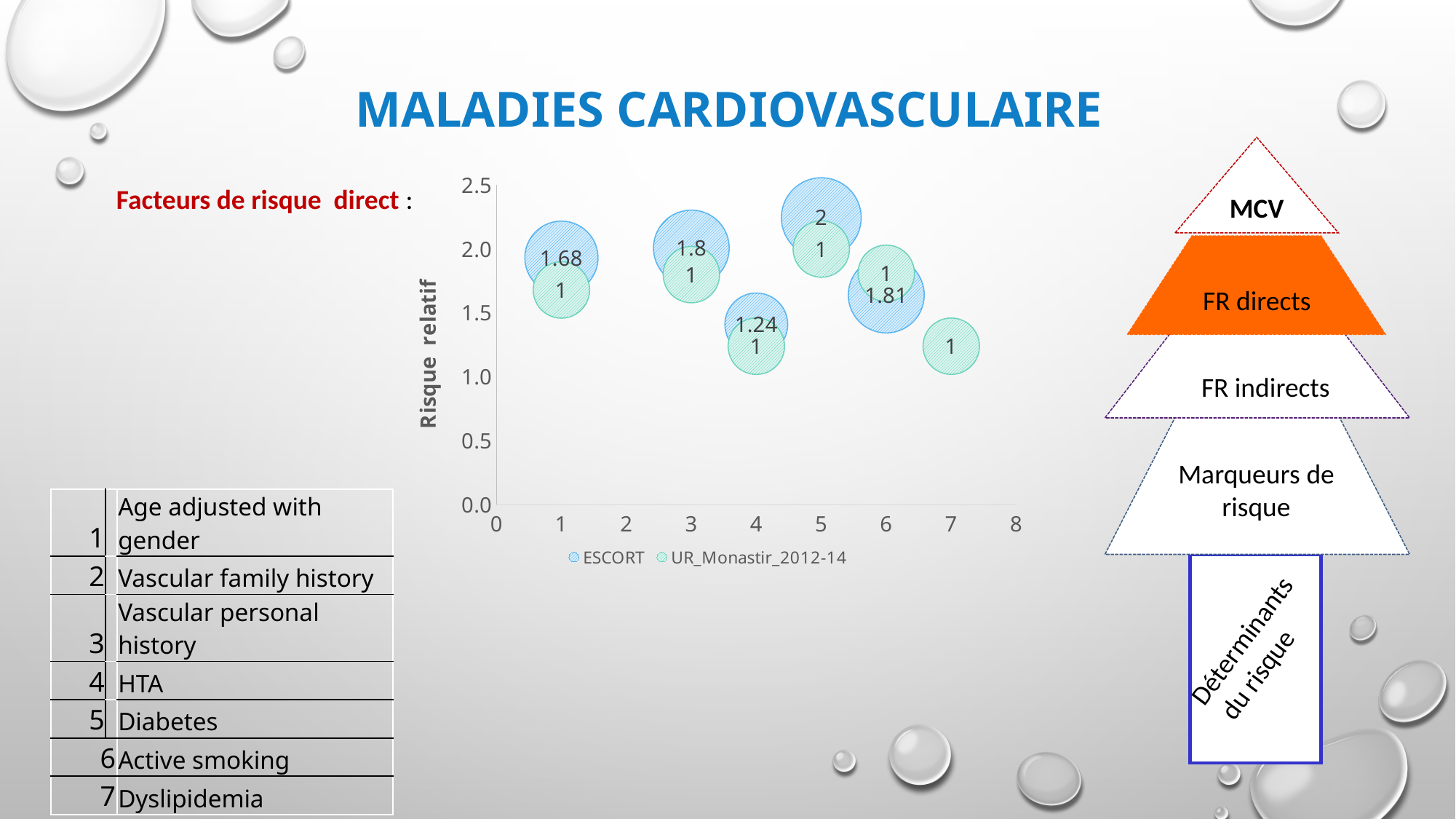
What is the title of the vertical axis of the chart? Risque relatif At which x position does the ESCORT series reach its highest value? 5 What is the ESCORT value at x = 3? 1.8 At which x position does the ESCORT series have its lowest value? 4 How many series does the legend list? 2 What is the difference between the ESCORT value at x = 5 and the ESCORT value at x = 4? 0.76 What kind of chart is shown on the slide? Bubble chart What is the UR_Monastir_2012-14 value at x = 7? 1 Which is larger: the ESCORT value at x = 1 or the ESCORT value at x = 3? ESCORT at x = 3 What is the ESCORT value at x = 1? 1.68 What is the ESCORT value at x = 6? 1.81 What is the ESCORT value at x = 4? 1.24